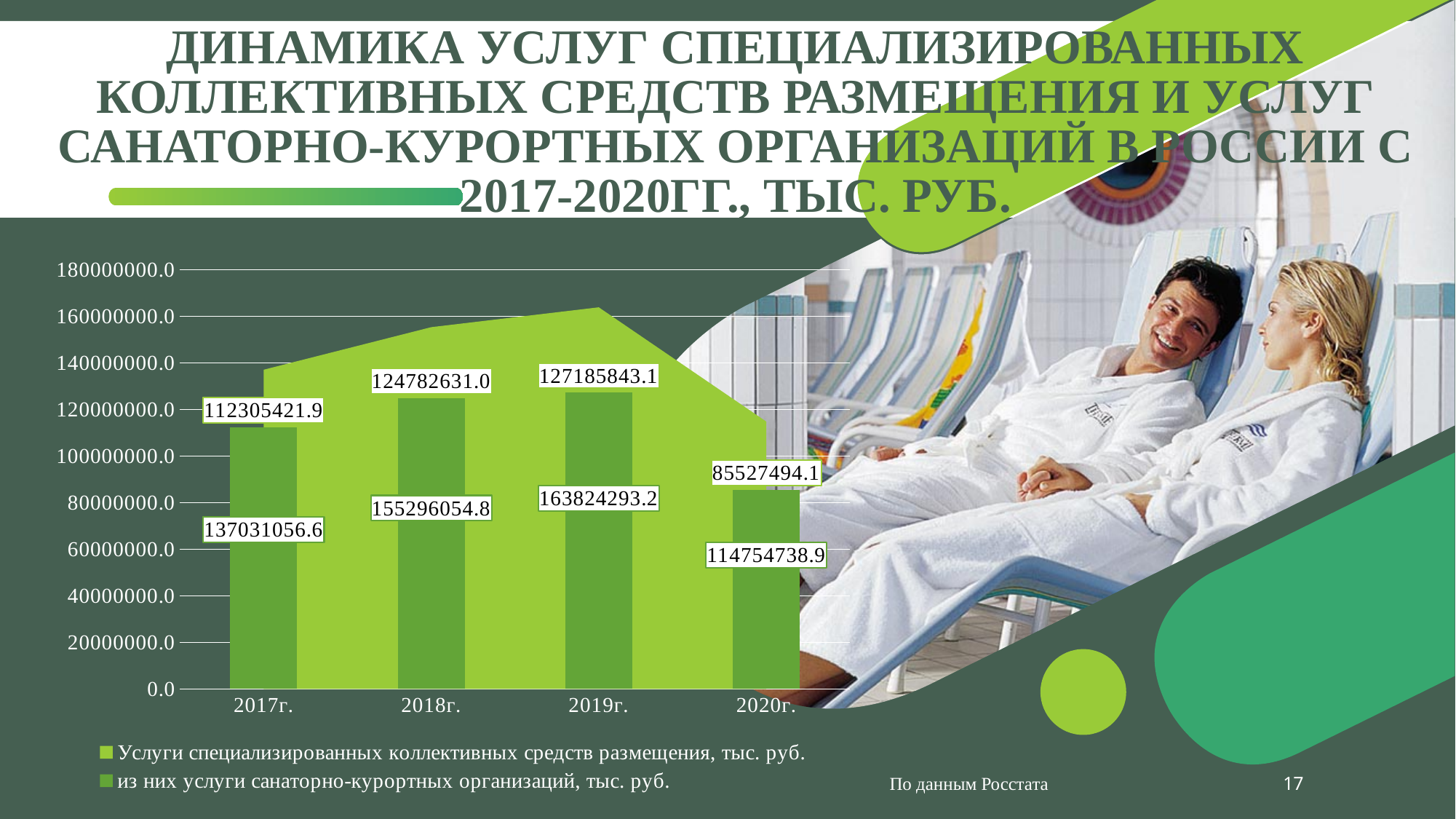
What is the difference between the two series' values for 2019г.? 36638450.1 Which year has the lowest value in the series 'из них услуги санаторно-курортных организаций, тыс. руб.'? 2020г. What is the value for 2020г. in the series 'из них услуги санаторно-курортных организаций, тыс. руб.'? 85527494.1 Which year has the highest value in the series 'Услуги специализированных коллективных средств размещения, тыс. руб.'? 2019г. How many series does the chart legend list? 2 What is the value for 2017г. in the series 'Услуги специализированных коллективных средств размещения, тыс. руб.'? 137031056.6 Does the series 'из них услуги санаторно-курортных организаций, тыс. руб.' rise or fall from 2019г. to 2020г.? fall By how much did the value of 'из них услуги санаторно-курортных организаций, тыс. руб.' increase from 2017г. to 2018г.? 12477209.1 What is the value for 2019г. in the series 'из них услуги санаторно-курортных организаций, тыс. руб.'? 127185843.1 How many years are shown on the x axis of the chart? 4 What is the value for 2018г. in the series 'Услуги специализированных коллективных средств размещения, тыс. руб.'? 155296054.8 Which is larger: the 2018г. value or the 2020г. value in the series 'из них услуги санаторно-курортных организаций, тыс. руб.'? 2018г.